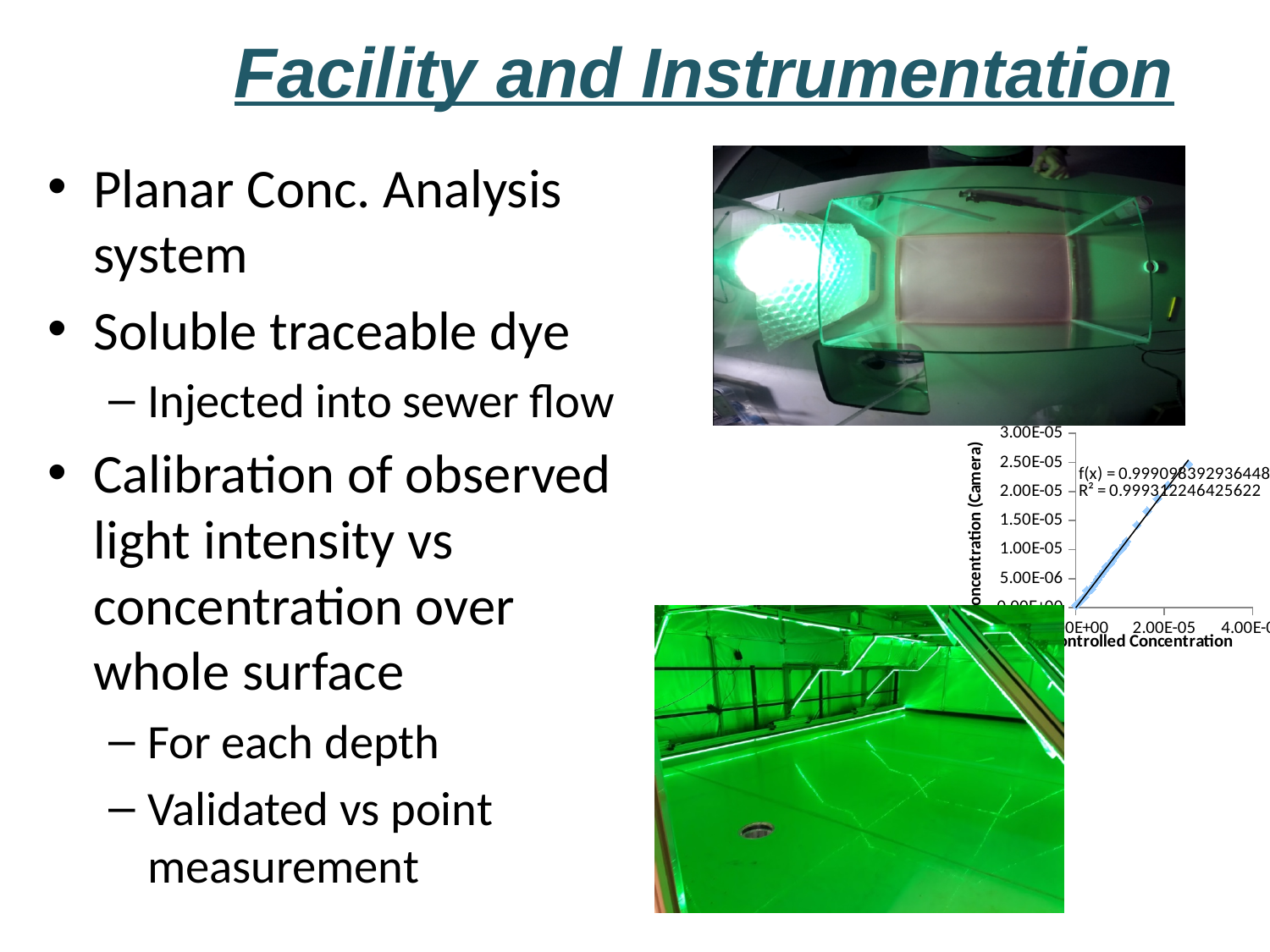
Is the highest plotted point on the chart greater or less than 2.00E-05 on the y axis? greater What is the label of the chart's y axis? Concentration (Camera) What is the highest tick value shown on the chart's y axis? 3.00E-05 Do the plotted points rise or fall as the controlled concentration increases along the x axis? rise Is the highest plotted point on the chart greater or less than 3.00E-05 on the y axis? less What is the R² value printed on the chart? 0.999312246425622 What kind of chart is shown on the slide? scatter chart